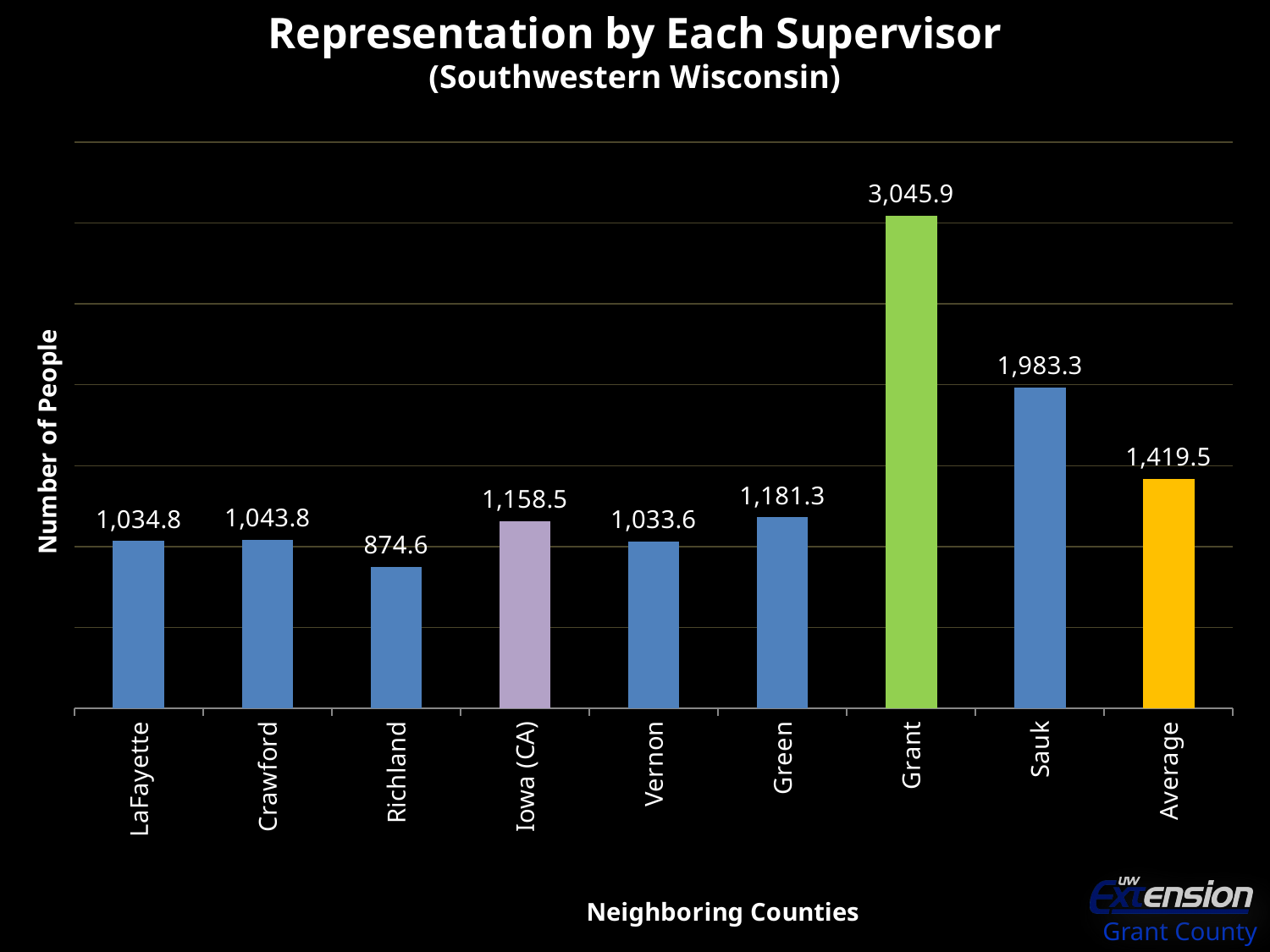
Which is larger, the value for Green or the value for Vernon? Green What is the value for Richland? 874.6 What is the value for Grant? 3,045.9 What is the label of the x axis? Neighboring Counties What is the difference between the values for Grant and Sauk? 1,062.6 How many bars are shown on the chart? 9 Which category has the highest value? Grant What is the title of the chart? Representation by Each Supervisor (Southwestern Wisconsin) What is the value shown for Average? 1,419.5 What kind of chart is this? Bar chart What is the value for Iowa (CA)? 1,158.5 Which category has the lowest value? Richland